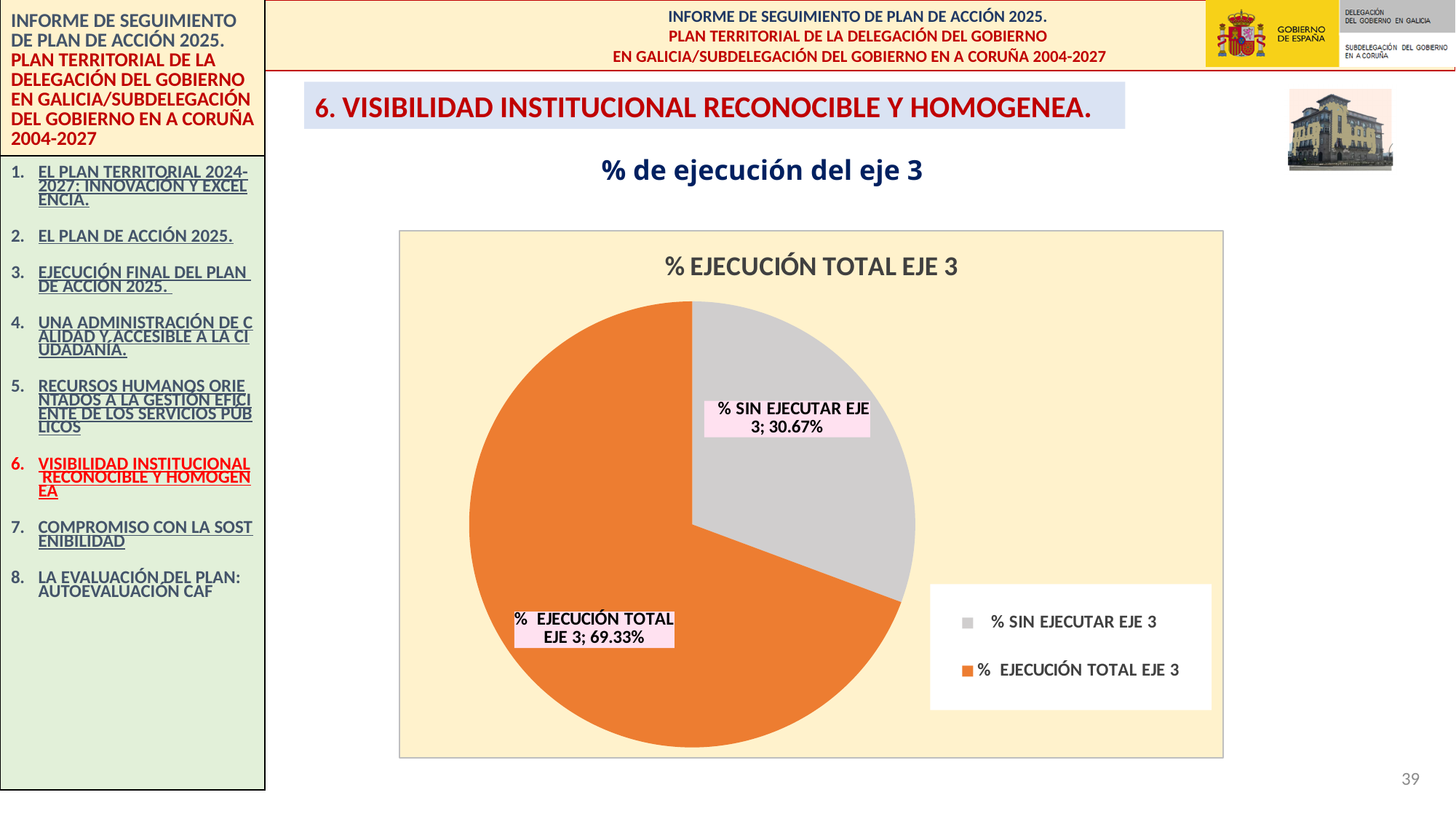
What is the value shown for % EJECUCIÓN TOTAL EJE 3? 69.33% What is the title of the chart? % EJECUCIÓN TOTAL EJE 3 What share of the pie does the % SIN EJECUTAR EJE 3 slice represent? 30.67% How many slices does the pie chart have? 2 What kind of chart is shown on the slide? Pie chart Which slice of the pie is the largest? % EJECUCIÓN TOTAL EJE 3 How many entries does the legend list? 2 What is the value shown for % SIN EJECUTAR EJE 3? 30.67% Which slice of the pie is the smallest? % SIN EJECUTAR EJE 3 Which is larger, % SIN EJECUTAR EJE 3 or % EJECUCIÓN TOTAL EJE 3? % EJECUCIÓN TOTAL EJE 3 What is the difference between the % EJECUCIÓN TOTAL EJE 3 slice and the % SIN EJECUTAR EJE 3 slice? 38.66% What colour is the % EJECUCIÓN TOTAL EJE 3 slice? Orange